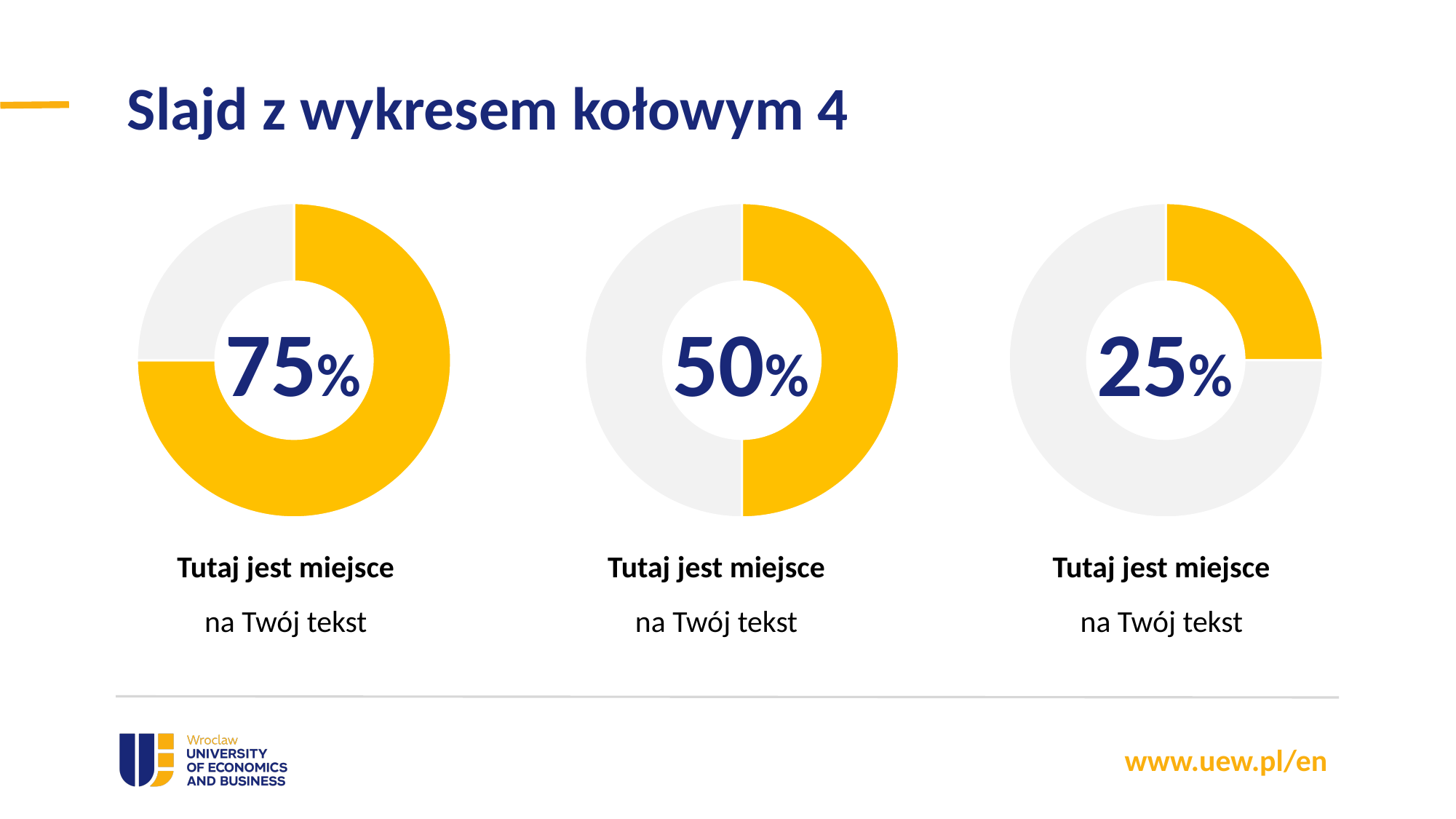
Is the percentage in the middle donut chart larger or smaller than the percentage in the left donut chart? smaller What kind of chart is used on this slide? donut (pie) chart What colour is the filled portion of each donut chart? yellow Which of the three donut charts shows the highest percentage: left, middle or right? left What percentage is shown in the centre of the middle donut chart? 50% How many donut charts are shown on the slide? 3 What is the title of the slide? Slajd z wykresem kołowym 4 Which of the three donut charts shows the lowest percentage: left, middle or right? right What percentage is shown in the centre of the left donut chart? 75% What percentage is shown in the centre of the right donut chart? 25% What is the difference between the percentage in the left donut chart and the percentage in the right donut chart? 50% What is the difference between the percentage in the middle donut chart and the percentage in the right donut chart? 25%